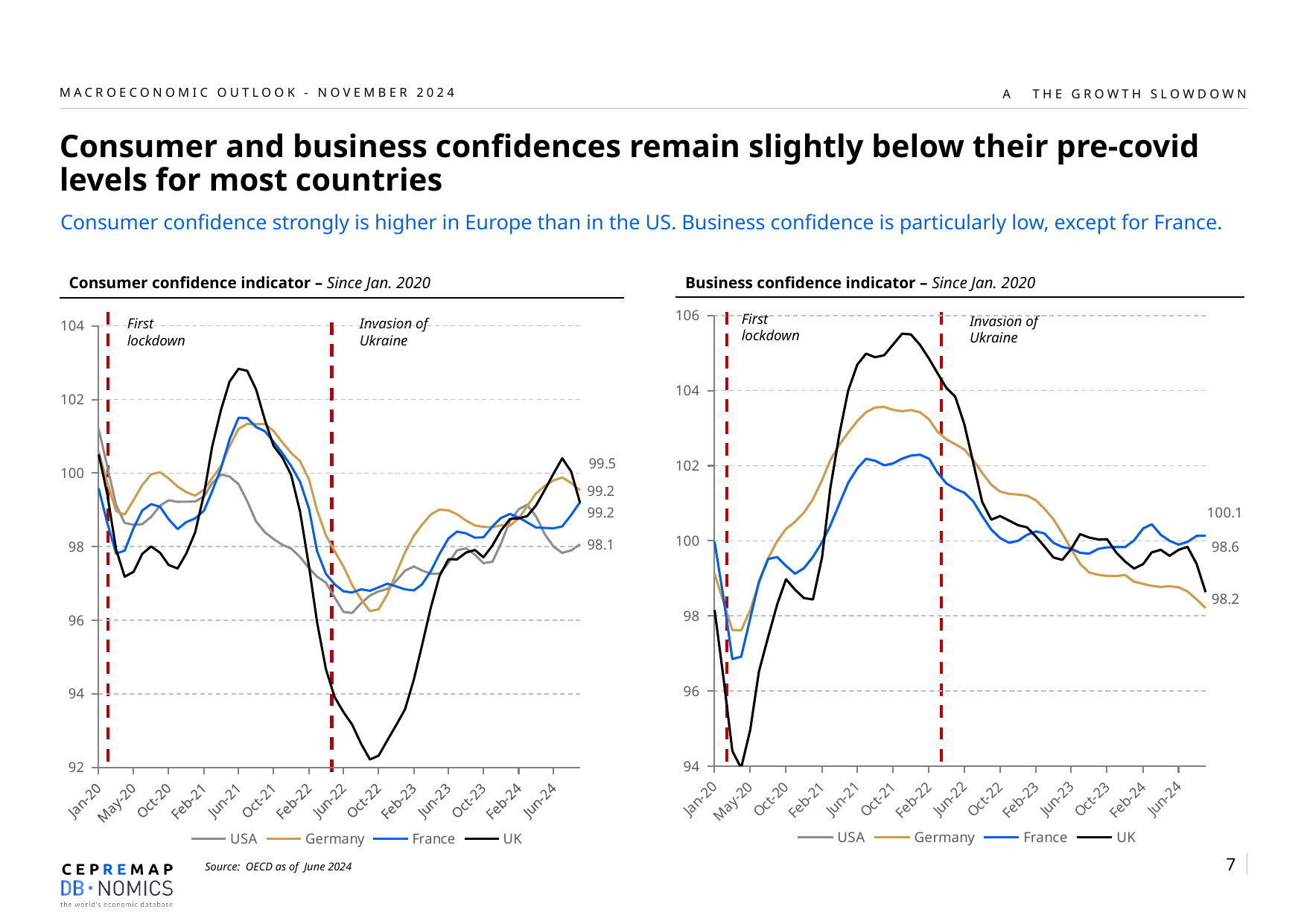
In the Business confidence indicator chart, is the UK peak around Oct-21 greater or less than 104? greater How many series does the legend of the Business confidence indicator chart list? 4 In the Business confidence indicator chart, what is the latest labelled value for the UK? 98.6 In the Business confidence indicator chart, which has the higher latest labelled value, France or the UK? France What event does the second red dashed vertical line mark in both charts? Invasion of Ukraine In the Business confidence indicator chart, what is the difference between the latest labelled values for France and Germany? 1.9 In the Consumer confidence indicator chart, what is the latest labelled value for the USA? 98.1 In the Business confidence indicator chart, what is the latest labelled value for Germany? 98.2 In the Business confidence indicator chart, which series has the highest latest labelled value? France In the Consumer confidence indicator chart, is the UK value around Oct-22 greater or less than 94? less In the Business confidence indicator chart, what is the latest labelled value for France? 100.1 What kind of chart is the Consumer confidence indicator chart? line chart